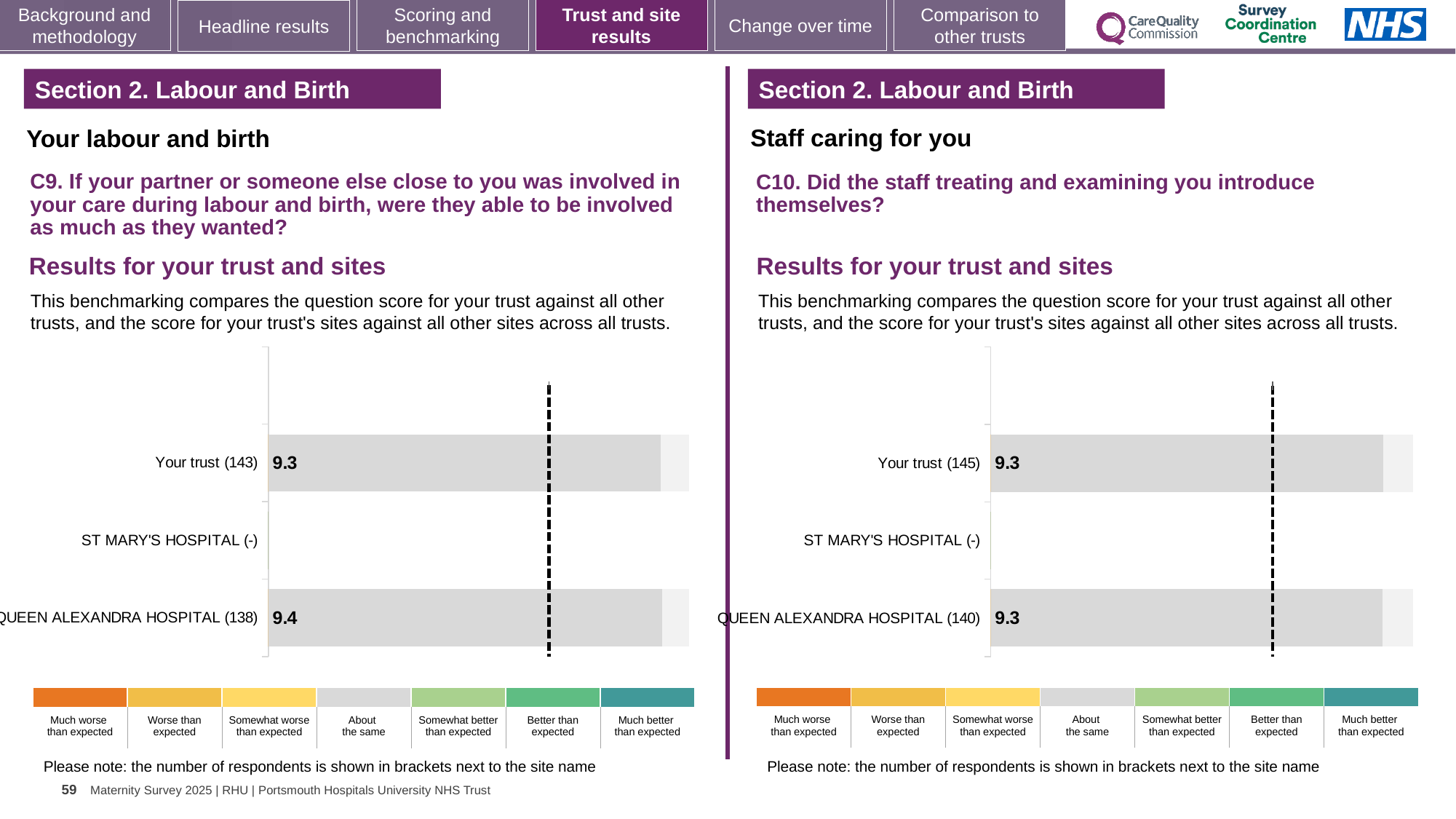
In the C9 chart on the left, what is the score for Queen Alexandra Hospital? 9.4 In the C9 chart on the left, which labelled row has the highest score? Queen Alexandra Hospital In the C9 chart on the left, which has the higher score, Your trust or Queen Alexandra Hospital? Queen Alexandra Hospital In the C10 chart on the right, how many respondents are shown in brackets for Queen Alexandra Hospital? 140 In the C10 chart on the right, is the score for Your trust the same as the score for Queen Alexandra Hospital? Yes In the C9 chart on the left, what is the difference between the Queen Alexandra Hospital score and the Your trust score? 0.1 In the C10 chart on the right, what is the score for Your trust? 9.3 In the C9 chart on the left, how many respondents are shown in brackets for Your trust? 143 How many site/trust rows are listed on the C10 chart on the right? 3 What kind of chart is used for the C9 results on the left? Bar chart In the C10 chart on the right, what is the score for Queen Alexandra Hospital? 9.3 In the C9 chart on the left, what is the score for Your trust? 9.3